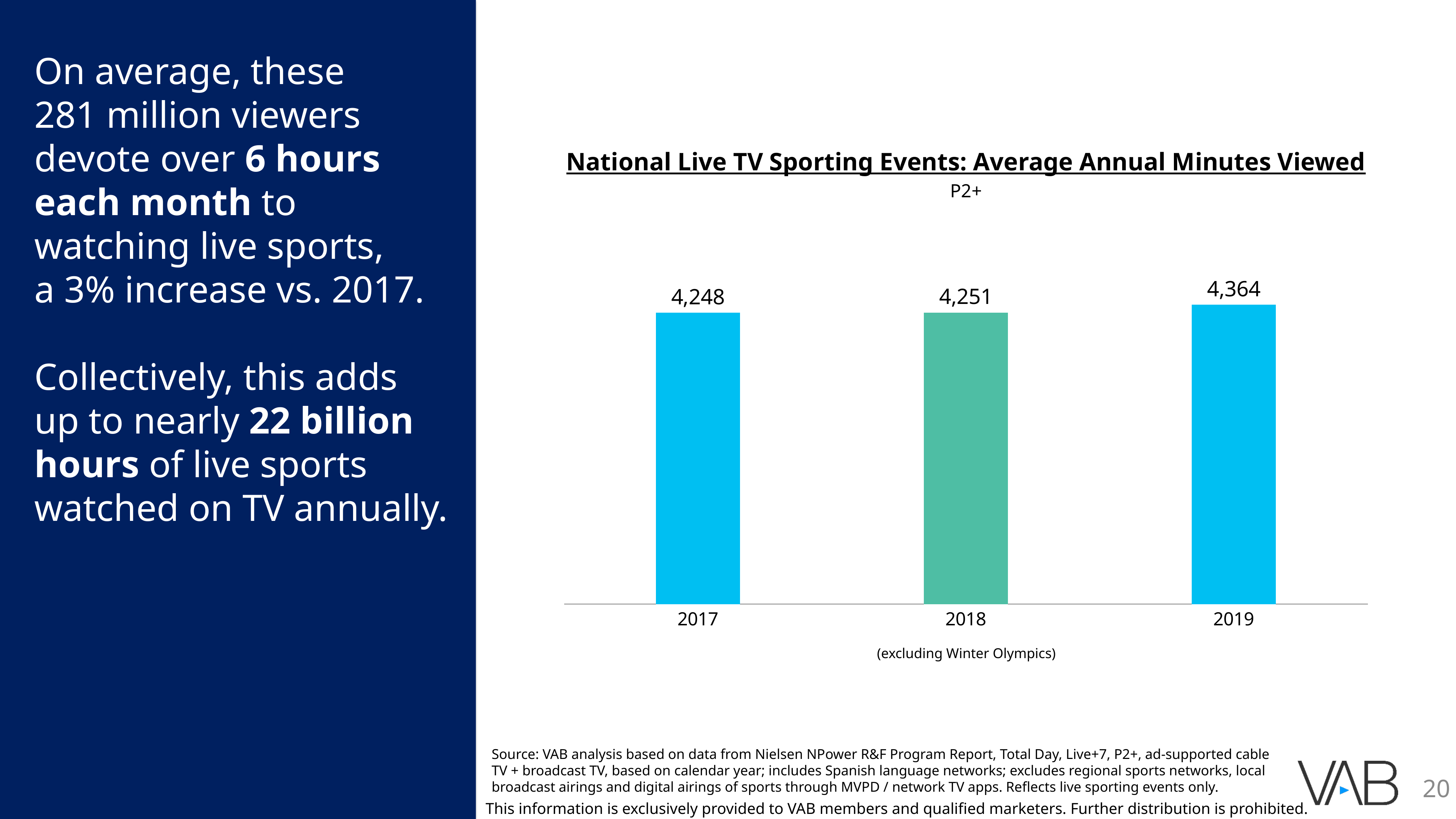
Which year has the lowest average annual minutes viewed? 2017 What is the difference between the 2018 and 2017 values? 3 What is the average annual minutes viewed value for 2019? 4,364 Do the values rise or fall from 2017 to 2019? Rise Which is larger, the value for 2019 or the value for 2018? 2019 How many years are shown on the chart? 3 What is the title of the chart? National Live TV Sporting Events: Average Annual Minutes Viewed Which year has the highest average annual minutes viewed? 2019 What is the average annual minutes viewed value for 2017? 4,248 What is the average annual minutes viewed value for 2018? 4,251 What is the difference between the 2019 and 2017 values? 116 What kind of chart is shown on the slide? Bar chart